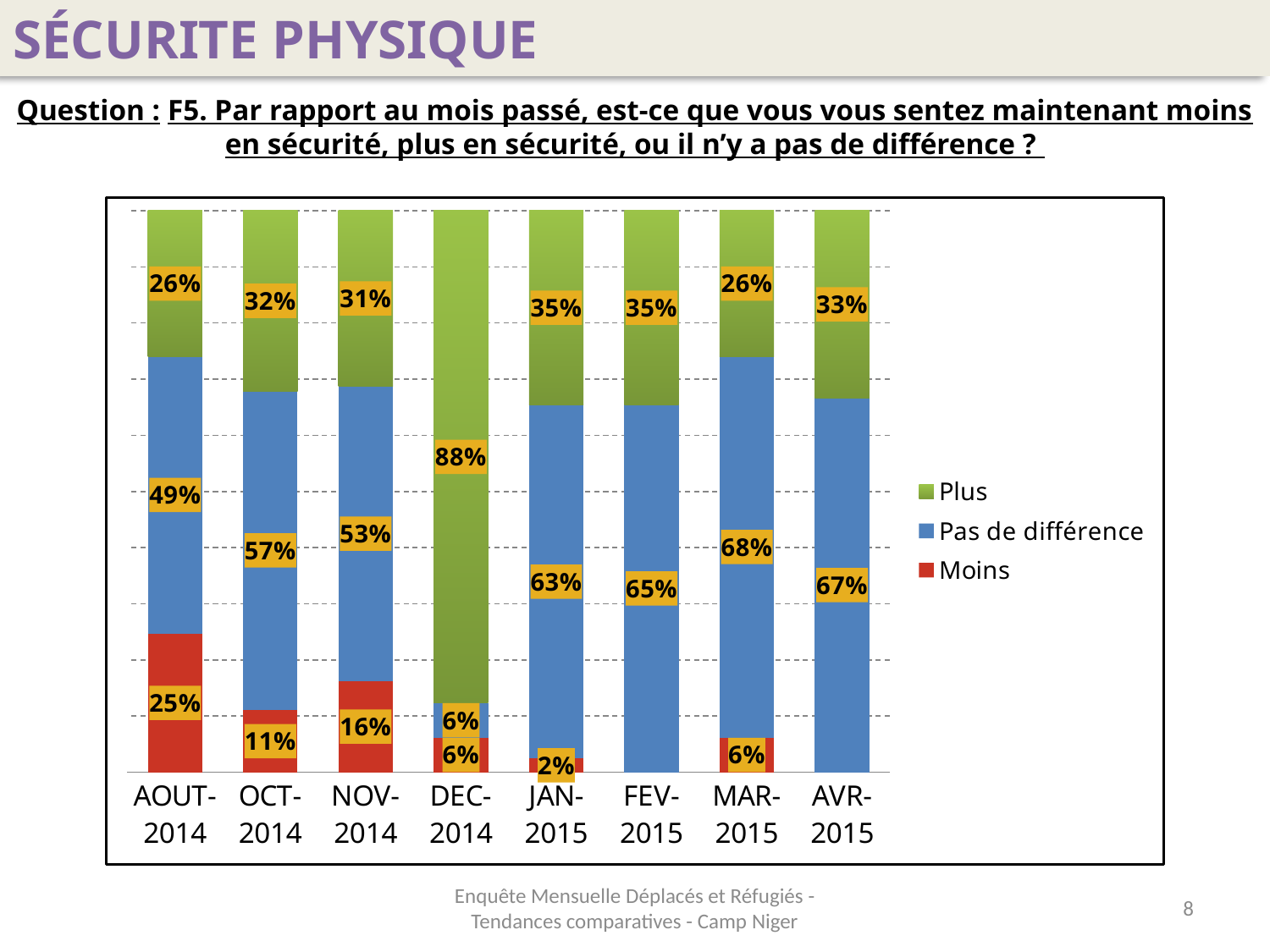
Which month has a larger Plus value, JAN-2015 or MAR-2015? JAN-2015 How many months are shown on the x axis? 8 Which month has the lowest value for the Pas de différence series? DEC-2014 What kind of chart is shown on the slide? Stacked bar chart What is the value of the Plus series for DEC-2014? 88% What is the value of the Plus series for OCT-2014? 32% Which month has the highest value for the Plus series? DEC-2014 How many series does the legend list? 3 What is the value of the Moins series for AOUT-2014? 25% What is the value of the Pas de différence series for MAR-2015? 68% Which month has the highest value for the Moins series? AOUT-2014 What is the difference between the Pas de différence values for OCT-2014 and NOV-2014? 4 percentage points